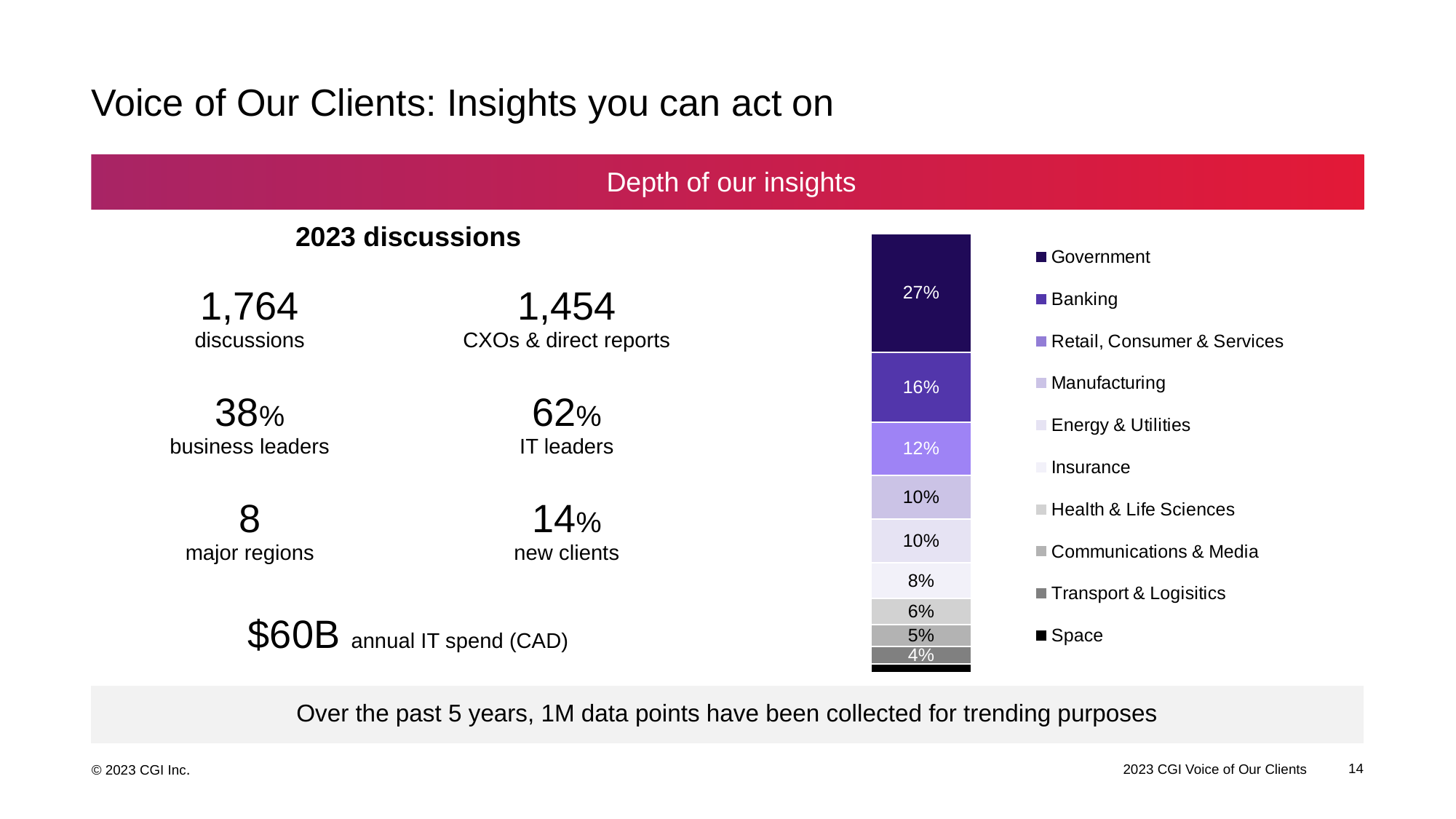
How many percentage points larger is the Government segment than the Banking segment? 11 percentage points What is the difference between the Manufacturing and Health & Life Sciences segments in the stacked bar chart? 4 percentage points What percentage is shown for Banking in the stacked bar chart? 16% What share does Government account for in the stacked bar chart? 27% What type of chart is shown on the right side of the slide? Stacked bar chart What percentage does Insurance represent in the stacked bar chart? 8% Which is larger in the stacked bar chart, Banking or Retail, Consumer & Services? Banking What is the value shown for Transport & Logistics in the stacked bar chart? 4% Which industry has the largest segment in the stacked bar chart? Government How many industries does the legend of the stacked bar chart list? 10 What is the value for Retail, Consumer & Services in the stacked bar chart? 12% Which industry has the smallest segment in the stacked bar chart? Space